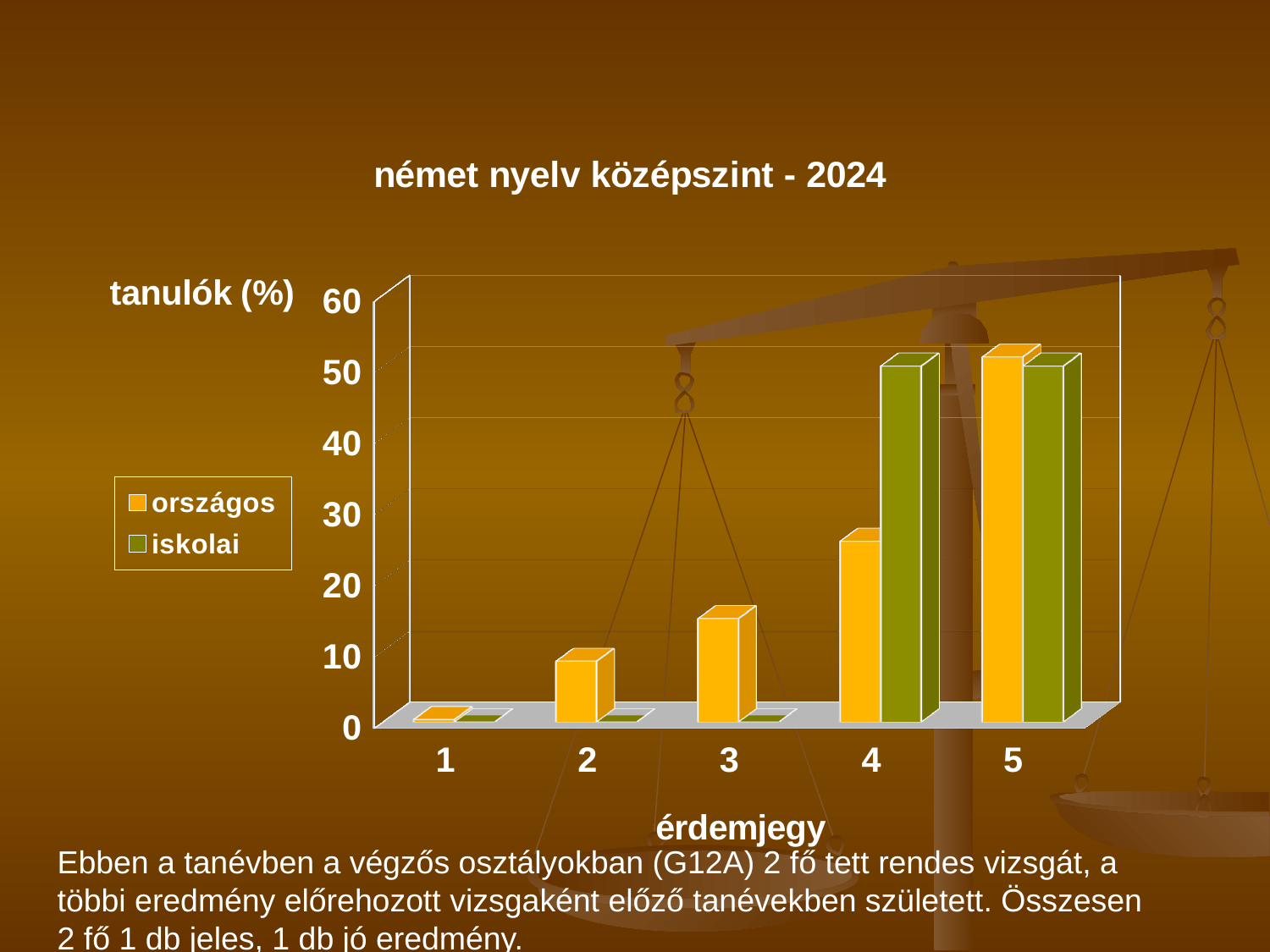
Is the országos value for érdemjegy 4 greater or less than 30? less What kind of chart is shown on the slide? bar chart How many categories (érdemjegy values) are shown on the x axis? 5 Is the országos value for érdemjegy 3 greater or less than 20? less Do the országos values rise or fall as érdemjegy increases from 1 to 5? rise Is the iskolai value for érdemjegy 4 greater or less than 40? greater Which érdemjegy has the highest országos value? 5 What is the title of the chart? német nyelv középszint - 2024 Which érdemjegy has the lowest országos value? 1 How many series does the legend list? 2 What label is shown on the x axis of the chart? érdemjegy For érdemjegy 4, which series has the larger value, országos or iskolai? iskolai